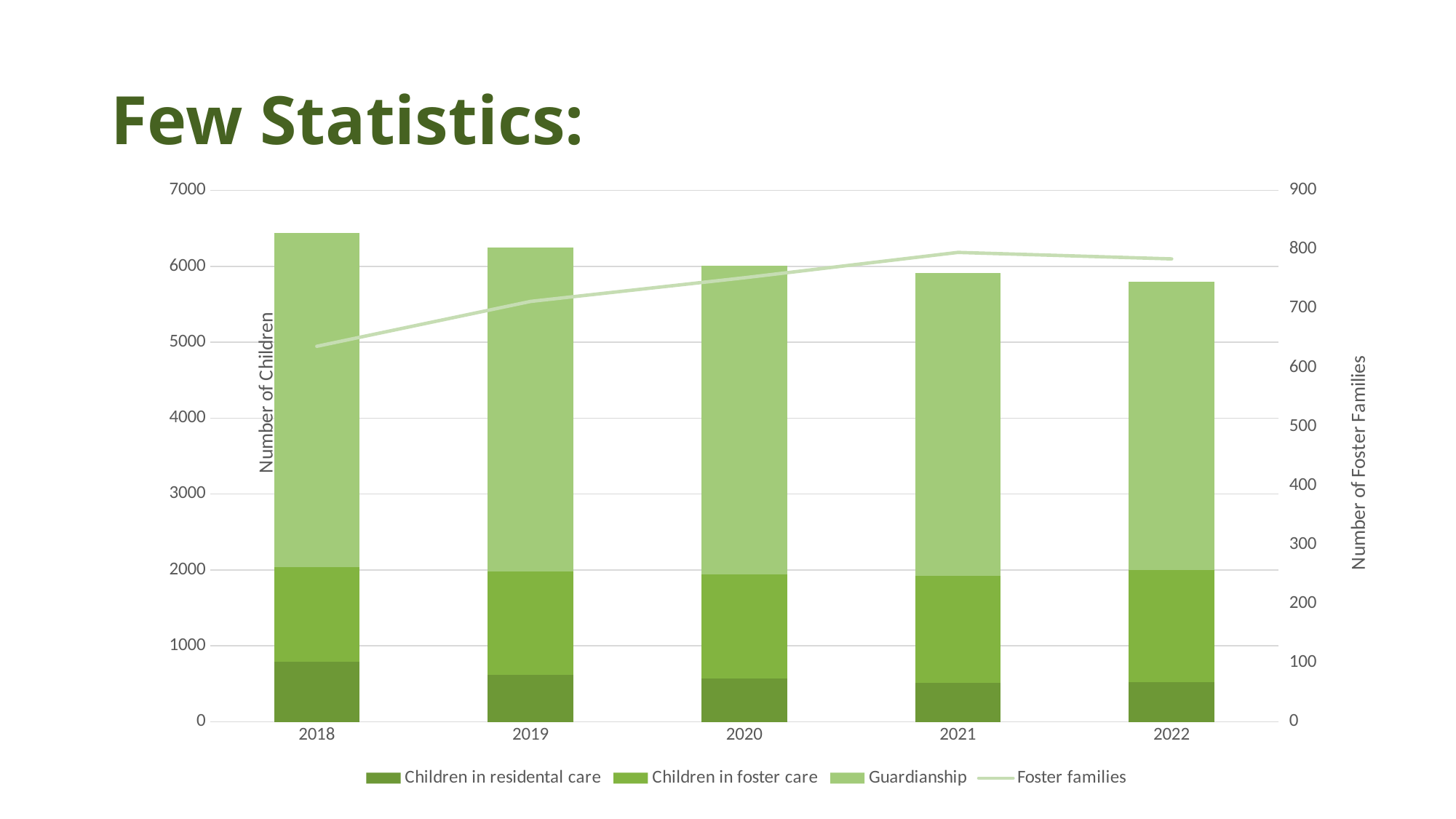
Is the value for Foster families in 2018 greater or less than 700? less What is the title of the right-hand vertical axis? Number of Foster Families Which year has the shortest stacked bar (lowest total number of children)? 2022 Is the value for Children in residental care in 2018 greater or less than 1000? less Which year has the tallest stacked bar (highest total number of children)? 2018 How many series does the legend list? 4 Which is larger, Children in residental care in 2018 or in 2021? 2018 Is the total stacked bar for 2018 greater or less than 6000? greater Do the total heights of the stacked bars rise or fall from 2018 to 2022? Fall How many years are shown on the x axis? 5 What kind of chart is shown on the slide? A stacked bar chart combined with a line